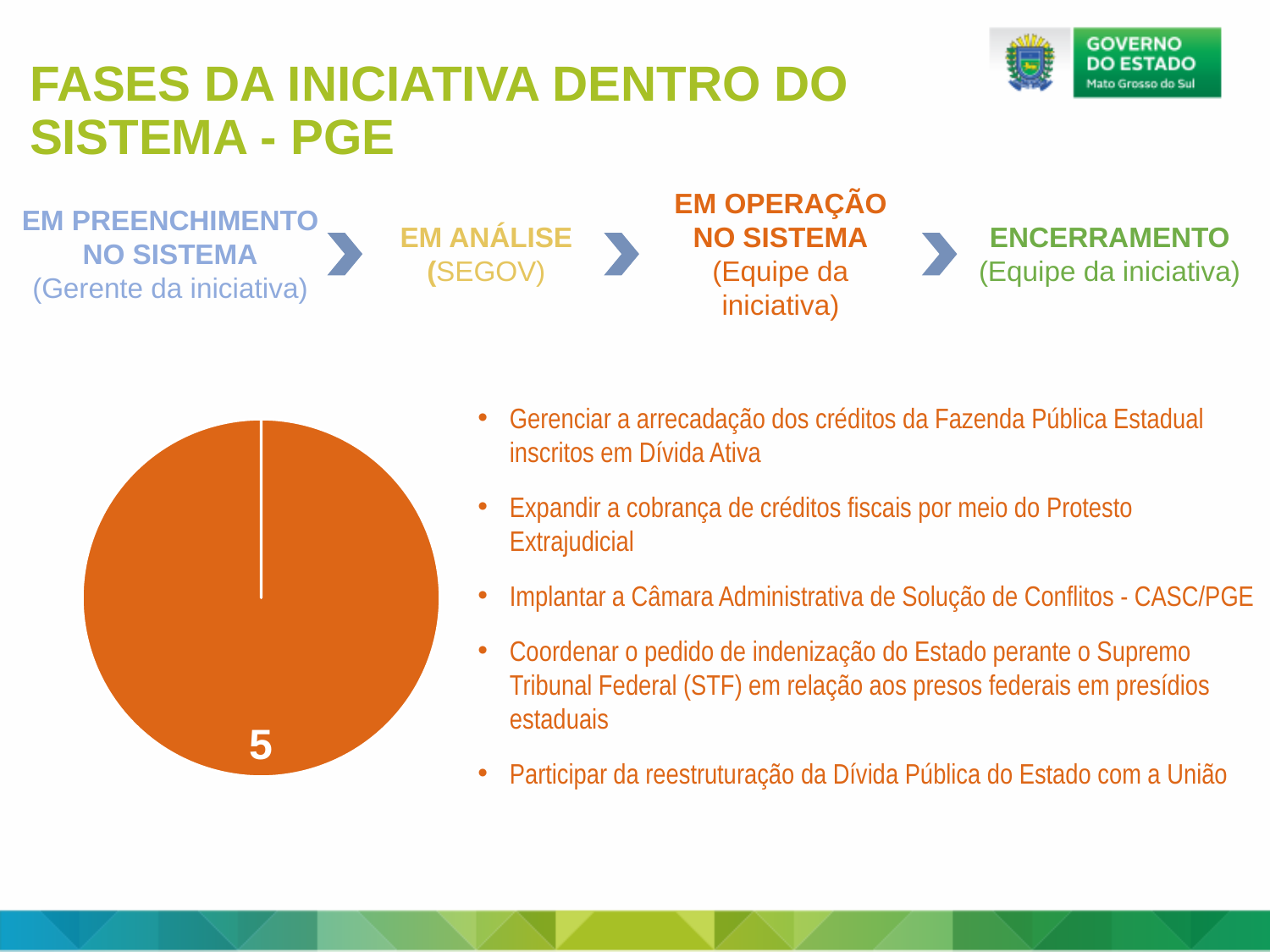
What kind of chart is shown on the left of the slide? pie chart Does the pie chart display a legend? No What colour is the slice of the pie chart? orange How many slices does the pie chart contain? 1 What value is printed as the data label on the pie chart? 5 What share of the pie chart does the single slice labelled 5 occupy? 100%